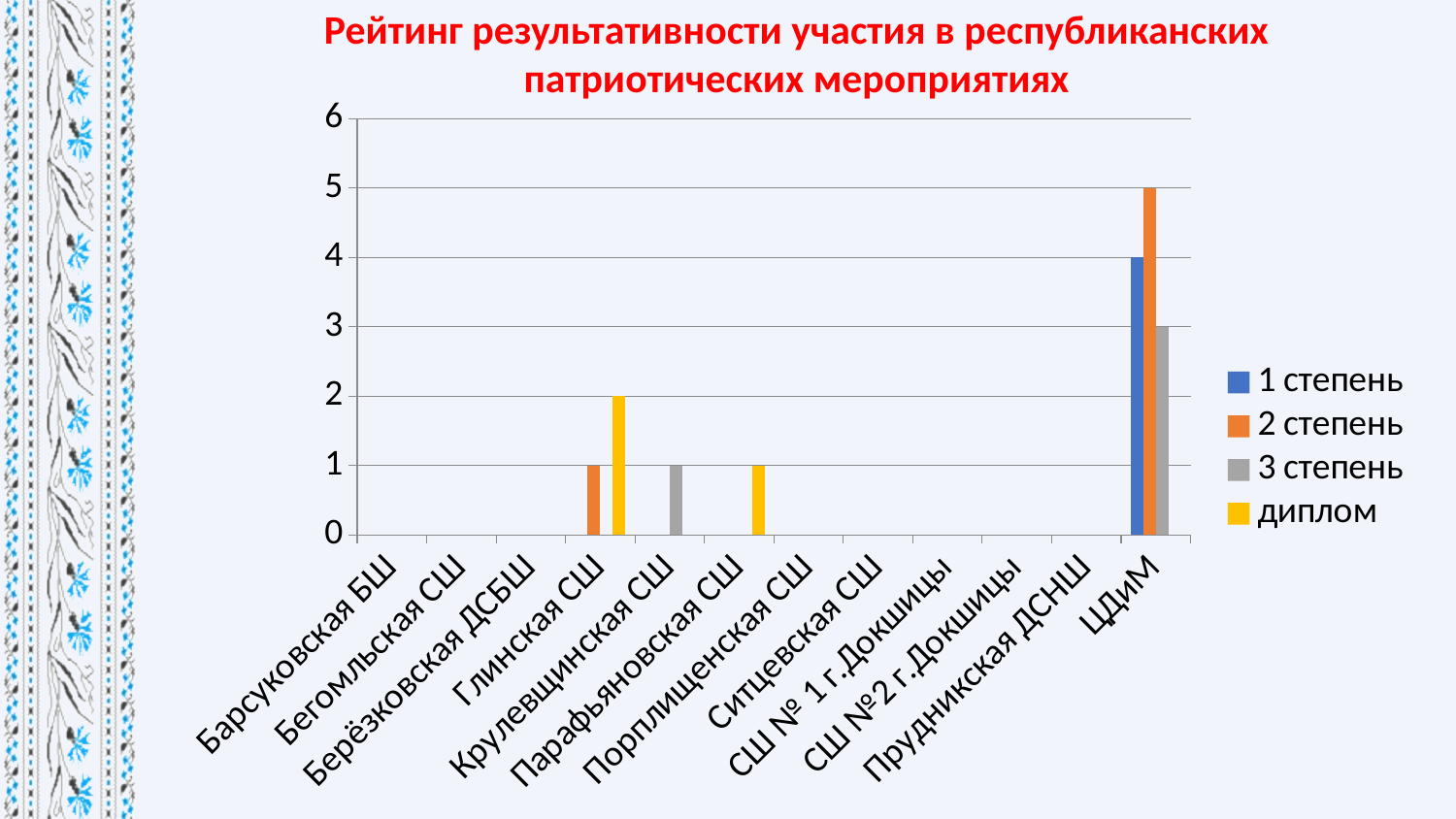
What is the difference between the '2 степень' and '3 степень' values for ЦДиМ? 2 What is the value of the '2 степень' series for ЦДиМ? 5 What is the title of the chart? Рейтинг результативности участия в республиканских патриотических мероприятиях What is the value of the '1 степень' series for ЦДиМ? 4 What kind of chart is shown on the slide? bar chart How many categories are shown on the x axis? 12 What is the value of the '3 степень' series for Крулевщинская СШ? 1 What is the value of the 'диплом' series for Глинская СШ? 2 What is the value of the '3 степень' series for ЦДиМ? 3 Which is larger for Глинская СШ: the 'диплом' value or the '2 степень' value? диплом How many series does the legend list? 4 Which category has the highest value in the '2 степень' series? ЦДиМ